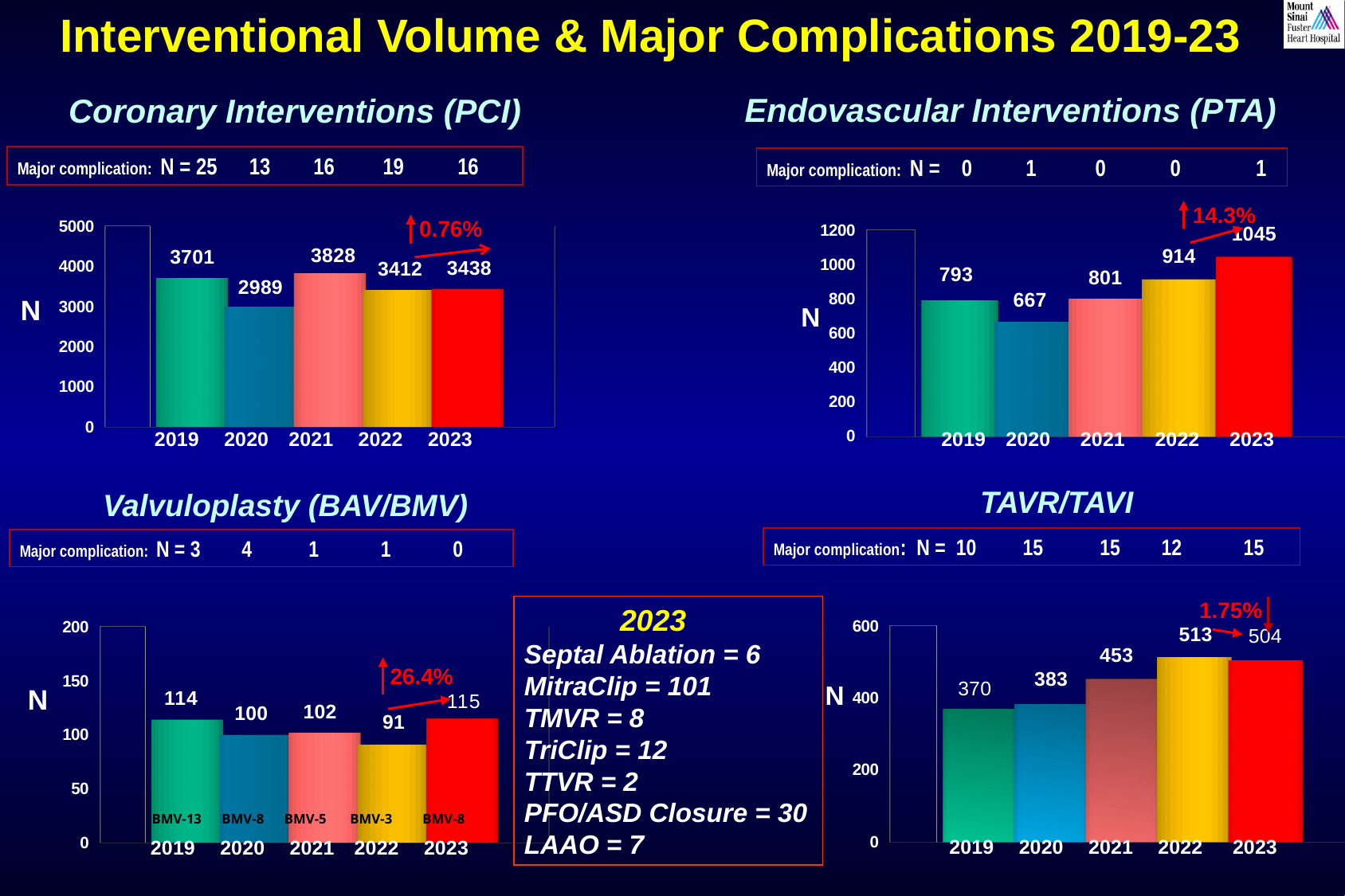
In the TAVR/TAVI chart, what is the value for 2021? 453 In the Endovascular Interventions (PTA) chart, what is the value for 2023? 1045 In the Endovascular Interventions (PTA) chart, is the value for 2020 greater or less than 800? less In the Valvuloplasty (BAV/BMV) chart, what is the value for 2022? 91 In the Valvuloplasty (BAV/BMV) chart, which is larger, the value for 2019 or the value for 2023? 2023 In the Coronary Interventions (PCI) chart, which year has the lowest value? 2020 In the Coronary Interventions (PCI) chart, what is the value for 2021? 3828 In the Endovascular Interventions (PTA) chart, which year has the highest value? 2023 In the TAVR/TAVI chart, what is the difference between the 2022 and 2023 values? 9 In the Endovascular Interventions (PTA) chart, what is the difference between the 2023 and 2022 values? 131 What type of chart is the TAVR/TAVI chart? Bar chart How many years are plotted in the Coronary Interventions (PCI) chart? 5